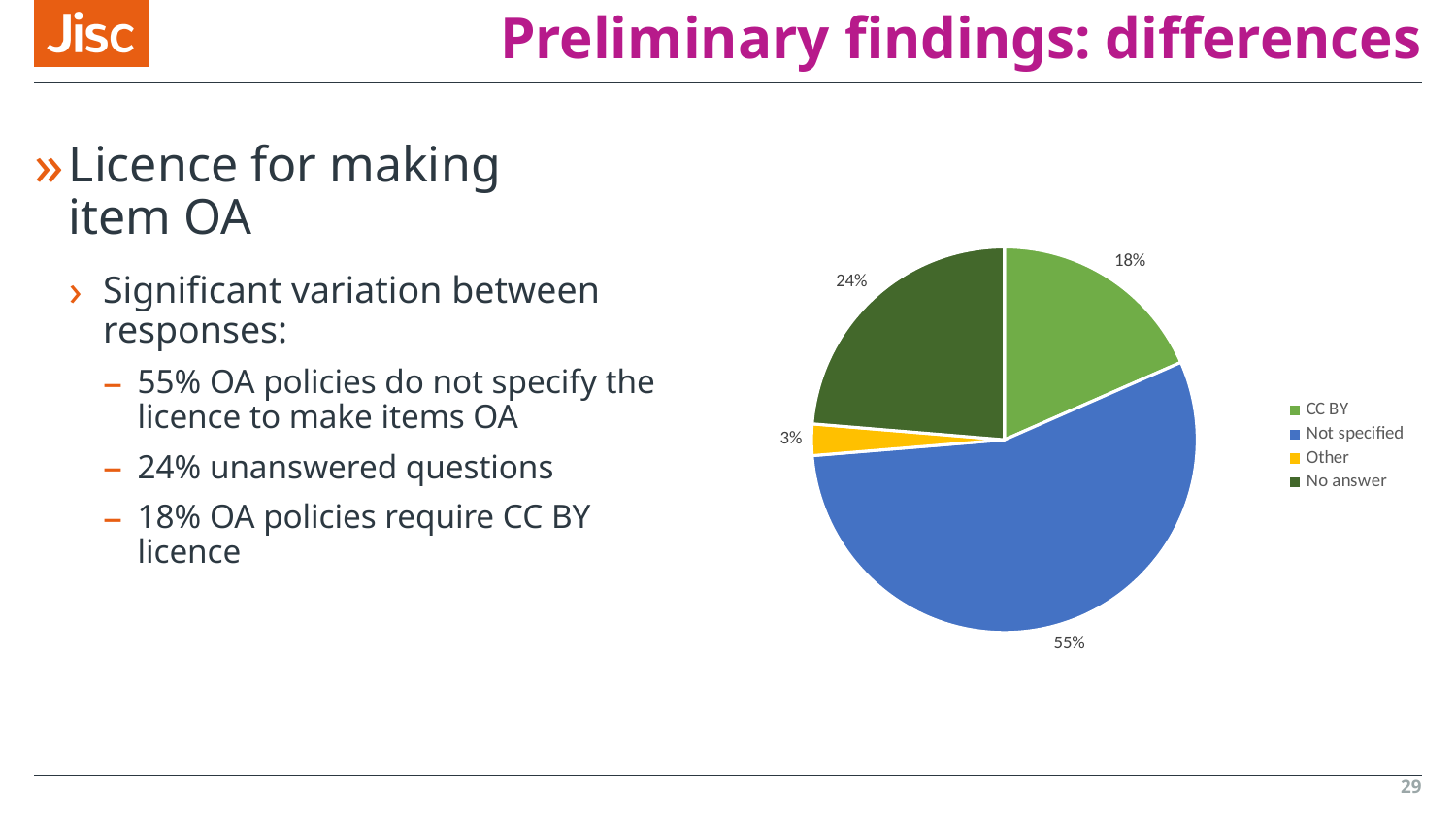
What share of the pie does the 'Not specified' slice represent? 55% What kind of chart is shown on the slide? pie chart What share of the pie does the 'CC BY' slice represent? 18% What is the difference between the 'Not specified' share and the 'No answer' share? 31% Which category has the largest slice of the pie? Not specified What colour is the 'Other' slice in the pie chart? yellow What is the difference between the 'No answer' share and the 'CC BY' share? 6% What share of the pie does the 'Other' slice represent? 3% Which is larger, the 'CC BY' slice or the 'No answer' slice? No answer How many categories does the pie chart have? 4 Which category has the smallest slice of the pie? Other